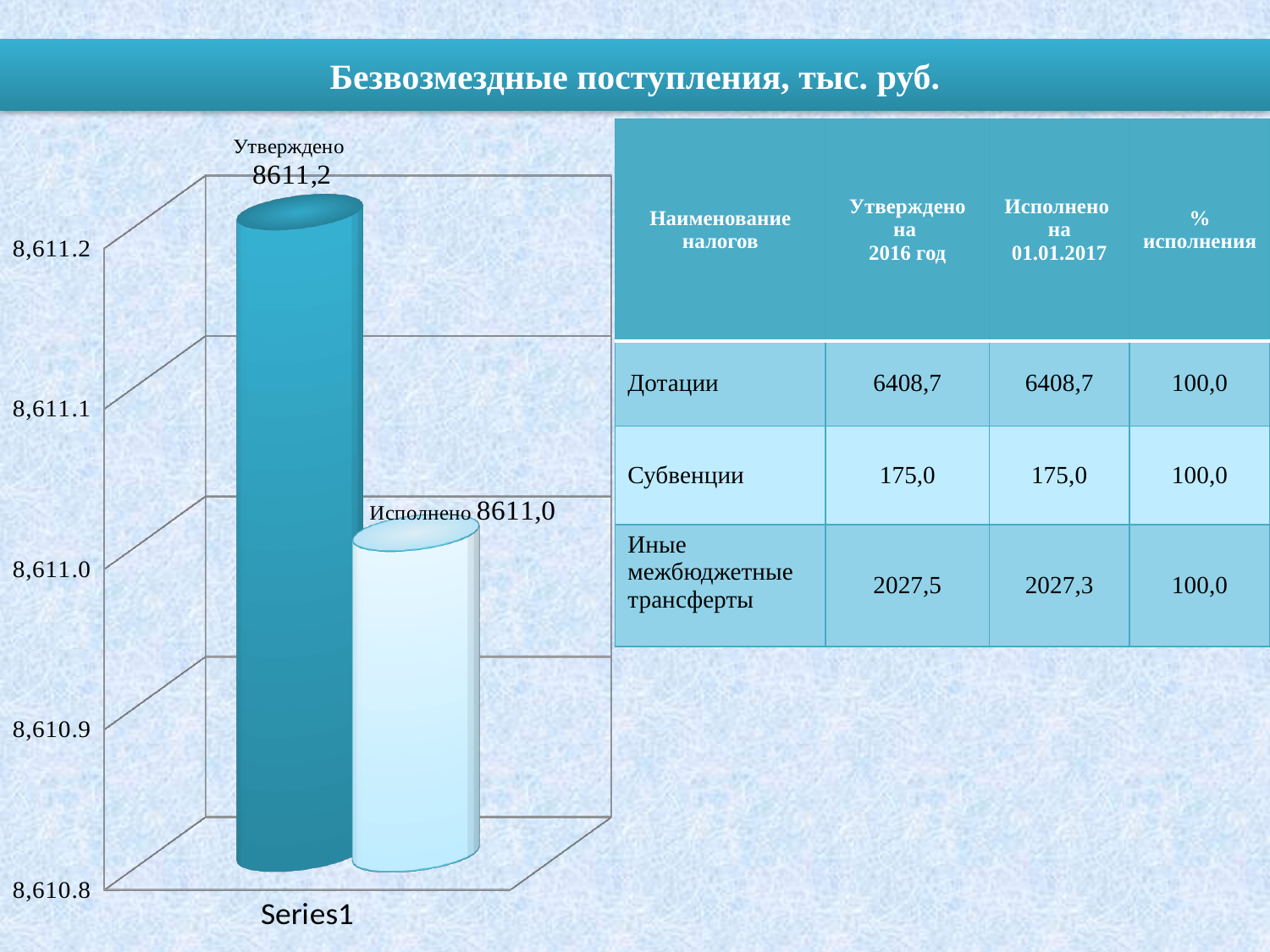
What kind of chart is shown on the slide? bar chart What value is shown for Исполнено in the chart? 8611,0 What value is shown for Утверждено in the chart? 8611,2 What is the title shown at the top of the slide above the chart? Безвозмездные поступления, тыс. руб. What is the difference between the Утверждено and Исполнено values in the chart? 0,2 How many bars are plotted in the chart? 2 Is the value for Исполнено in the chart greater or less than 8,610.9? greater Which bar in the chart is the lowest? Исполнено What label appears on the horizontal axis of the chart? Series1 Which bar in the chart is the highest? Утверждено Which is larger in the chart, Утверждено or Исполнено? Утверждено Is the value for Утверждено in the chart greater or less than 8,611.1? greater